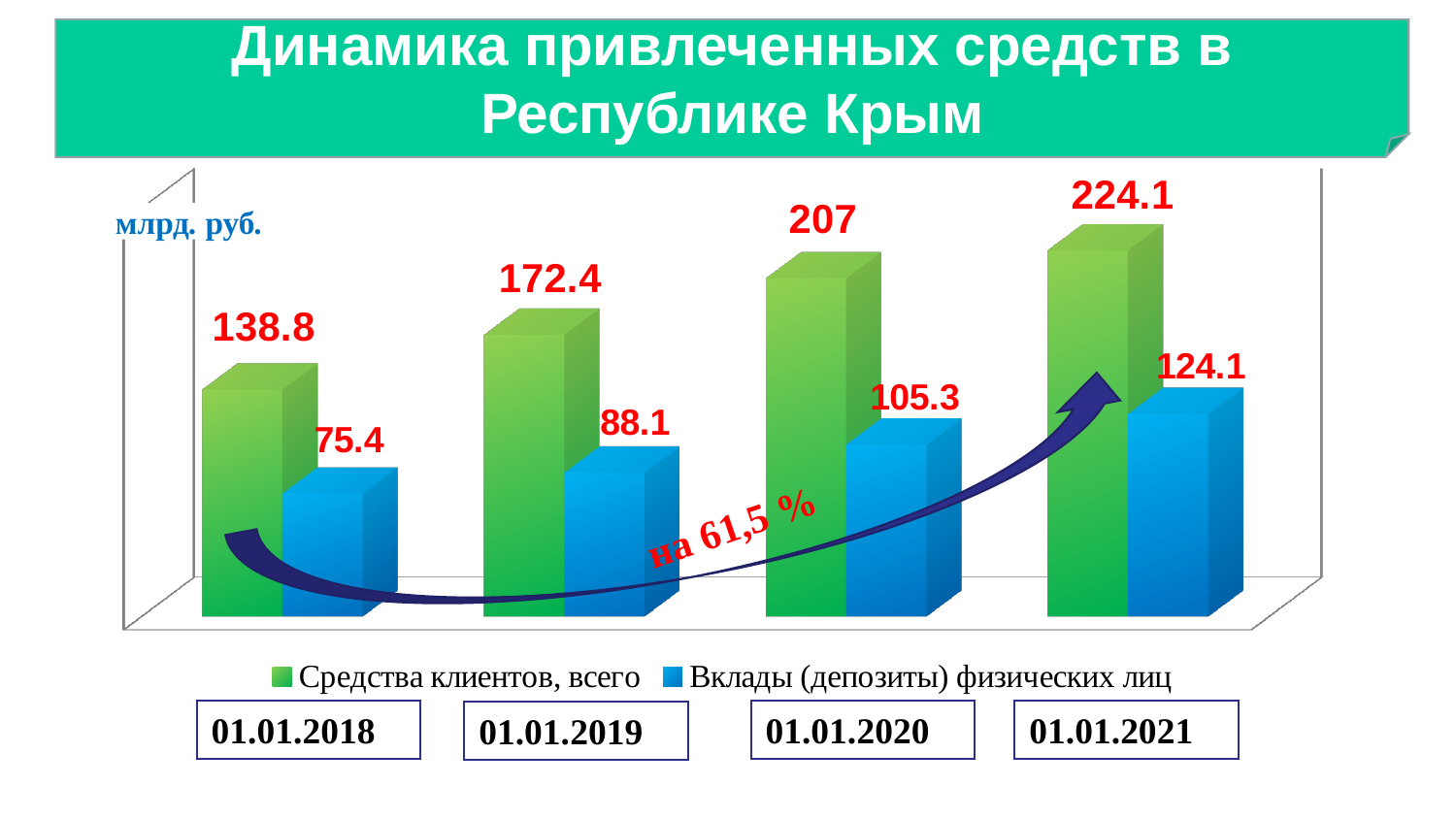
How many dates (categories) are shown on the x axis? 4 How many series does the legend list? 2 Do the values of "Средства клиентов, всего" rise or fall from 01.01.2018 to 01.01.2021? Rise On which date is "Вклады (депозиты) физических лиц" highest? 01.01.2021 What is the value of "Средства клиентов, всего" on 01.01.2020? 207 What is the value of "Вклады (депозиты) физических лиц" on 01.01.2018? 75.4 What is the value of "Вклады (депозиты) физических лиц" on 01.01.2019? 88.1 What kind of chart is shown on the slide? Bar chart Which is larger: "Вклады (депозиты) физических лиц" on 01.01.2021 or "Средства клиентов, всего" on 01.01.2018? Средства клиентов, всего on 01.01.2018 On which date is "Средства клиентов, всего" lowest? 01.01.2018 What is the value of "Средства клиентов, всего" on 01.01.2021? 224.1 What is the difference between "Средства клиентов, всего" and "Вклады (депозиты) физических лиц" on 01.01.2020? 101.7